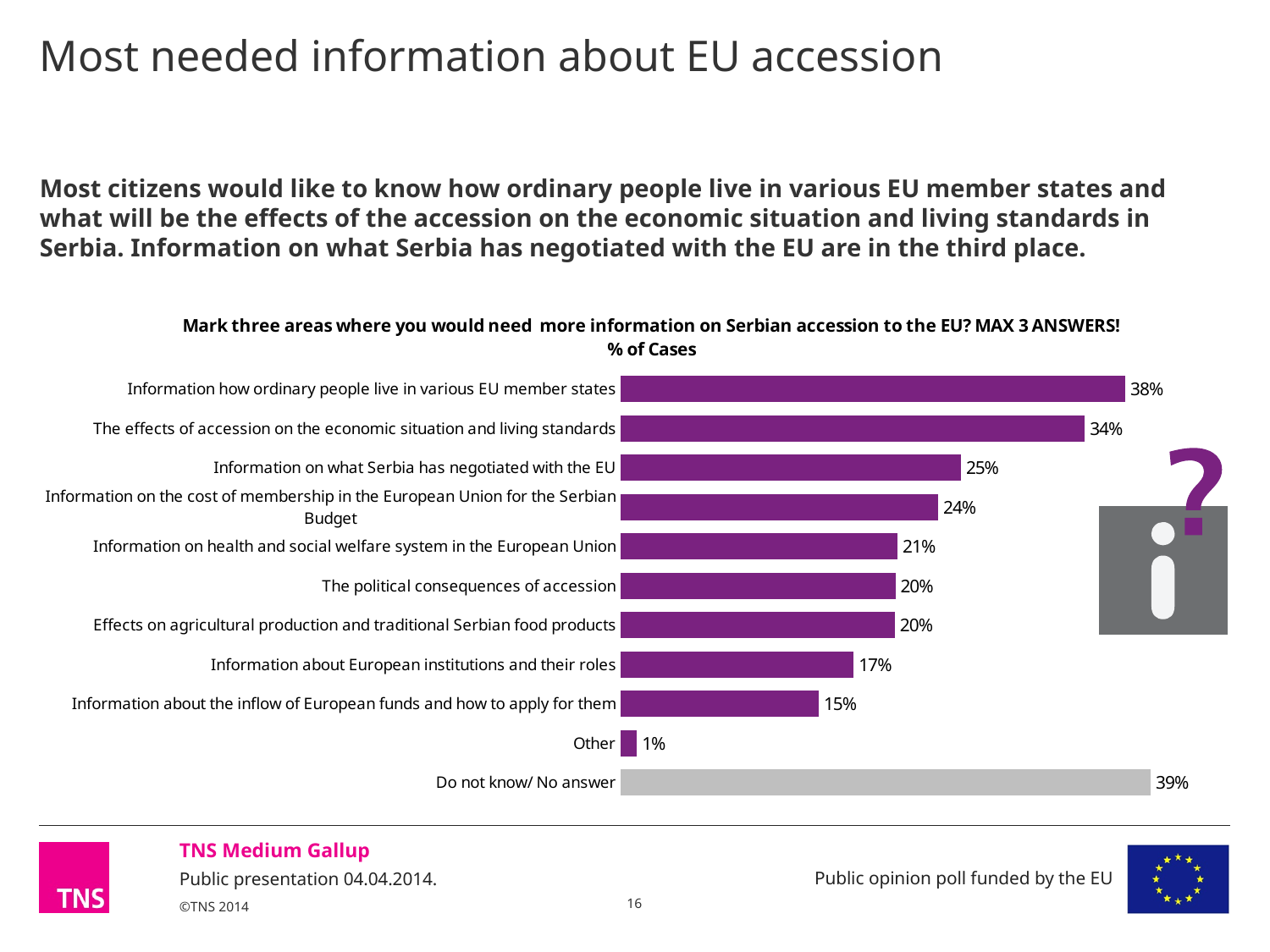
How many categories are shown in the chart? 11 Which is larger: 'Information on health and social welfare system in the European Union' or 'Information about European institutions and their roles'? Information on health and social welfare system in the European Union Which bar in the chart is shown in a different colour (grey) from the others? Do not know/ No answer What kind of chart is shown on the slide? Bar chart What is the difference between 'Information on the cost of membership in the European Union for the Serbian Budget' and 'Information about the inflow of European funds and how to apply for them'? 9% What is the value for 'Do not know/ No answer'? 39% Which category has the highest value in the chart? Do not know/ No answer Which category has the lowest value in the chart? Other What is the value for 'Information how ordinary people live in various EU member states'? 38% What is the difference between 'Information how ordinary people live in various EU member states' and 'The effects of accession on the economic situation and living standards'? 4% What is the value for 'Information about the inflow of European funds and how to apply for them'? 15% What is the value for 'Information on what Serbia has negotiated with the EU'? 25%